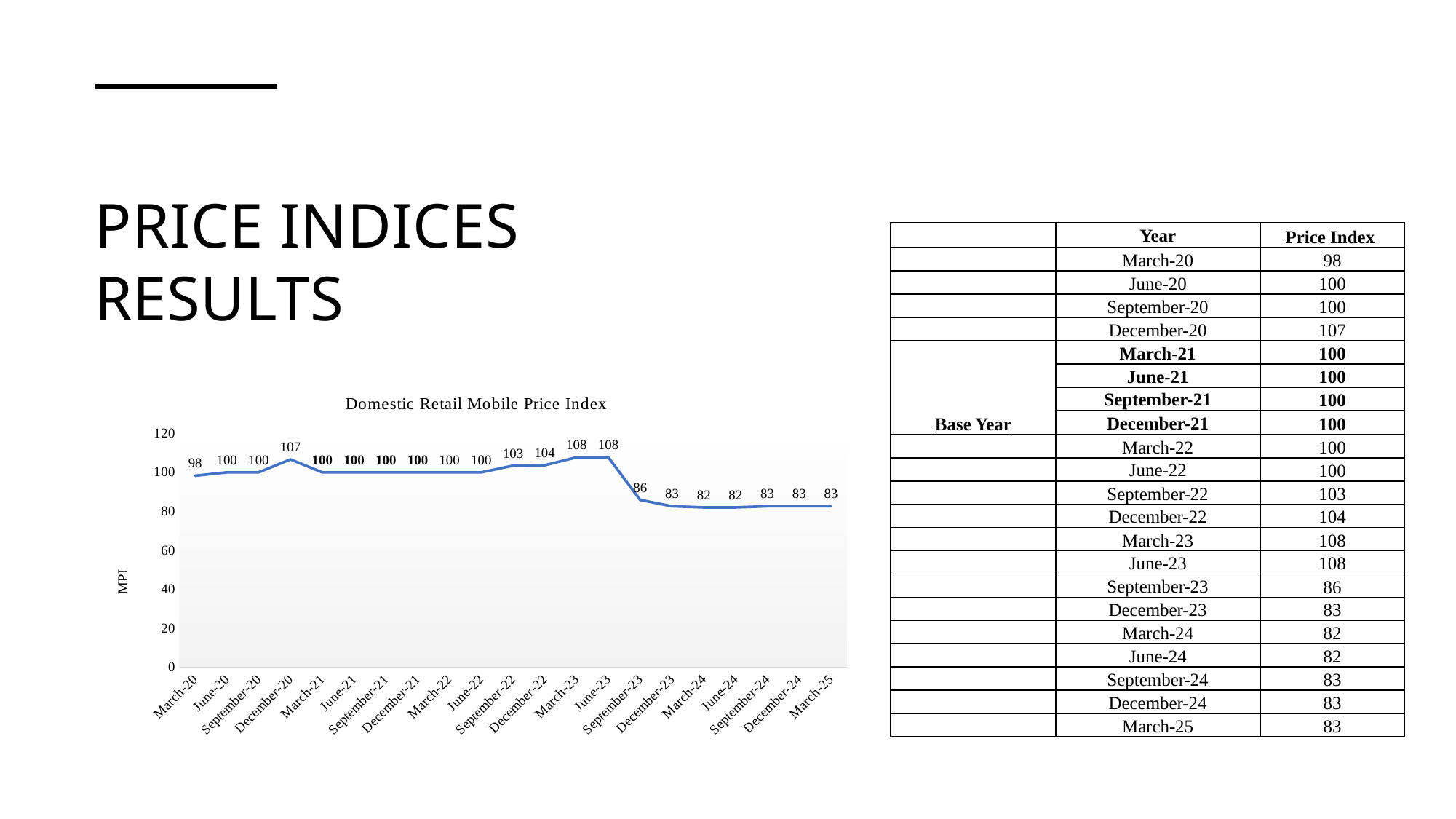
How many data points are plotted in the chart? 21 What is the title of the chart? Domestic Retail Mobile Price Index What is the value for December-20 in the chart? 107 What is the value for March-25 in the chart? 83 What is the highest value plotted in the chart? 108 What is the value for September-23 in the chart? 86 What is the difference between the values for June-23 and September-23? 22 Which has the larger value, December-20 or December-22? December-20 What is the lowest value plotted in the chart? 82 What type of chart is shown on the slide? line chart What is the label on the vertical axis of the chart? MPI What is the value for March-20 in the chart? 98